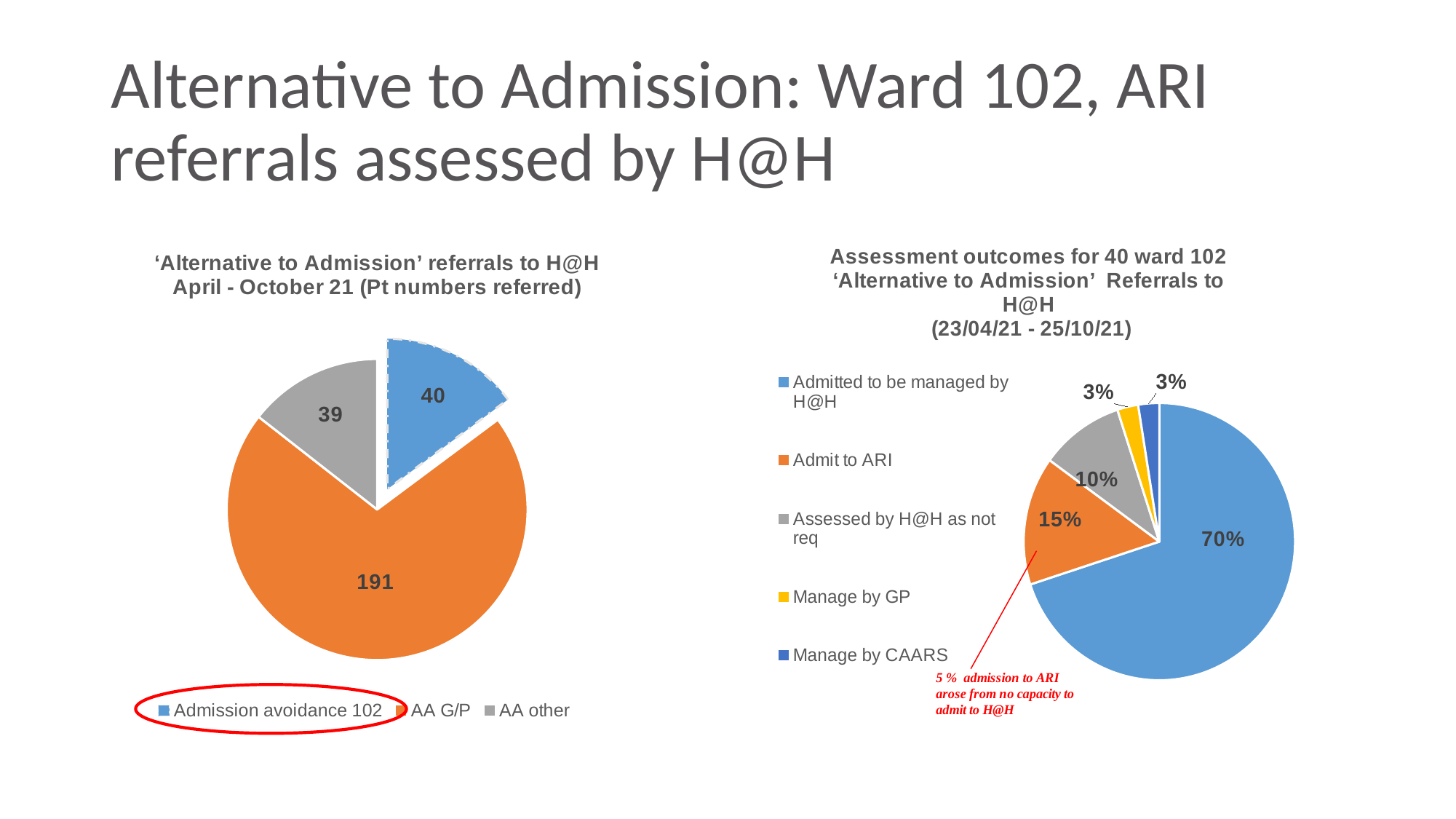
In the left pie chart ('Alternative to Admission' referrals to H@H April - October 21), how many categories does the legend list? 3 In the left pie chart ('Alternative to Admission' referrals to H@H April - October 21), what is the total of all three slices? 270 In the left pie chart ('Alternative to Admission' referrals to H@H April - October 21), what is the value for AA G/P? 191 In the left pie chart ('Alternative to Admission' referrals to H@H April - October 21), what is the difference between the AA G/P value and the AA other value? 152 In the right pie chart (Assessment outcomes for 40 ward 102 referrals), which is larger: the share for Admit to ARI or the share for Assessed by H@H as not req? Admit to ARI What type of chart is used on the right side of the slide? Pie chart In the right pie chart (Assessment outcomes for 40 ward 102 referrals), how many outcome categories does the legend list? 5 In the right pie chart (Assessment outcomes for 40 ward 102 referrals), which outcome has the largest share? Admitted to be managed by H@H In the right pie chart (Assessment outcomes for 40 ward 102 referrals), what percentage is shown for Admit to ARI? 15% In the right pie chart (Assessment outcomes for 40 ward 102 referrals), what percentage is shown for Assessed by H@H as not req? 10% In the left pie chart ('Alternative to Admission' referrals to H@H April - October 21), which category has the largest value? AA G/P In the left pie chart ('Alternative to Admission' referrals to H@H April - October 21), what is the value for Admission avoidance 102? 40